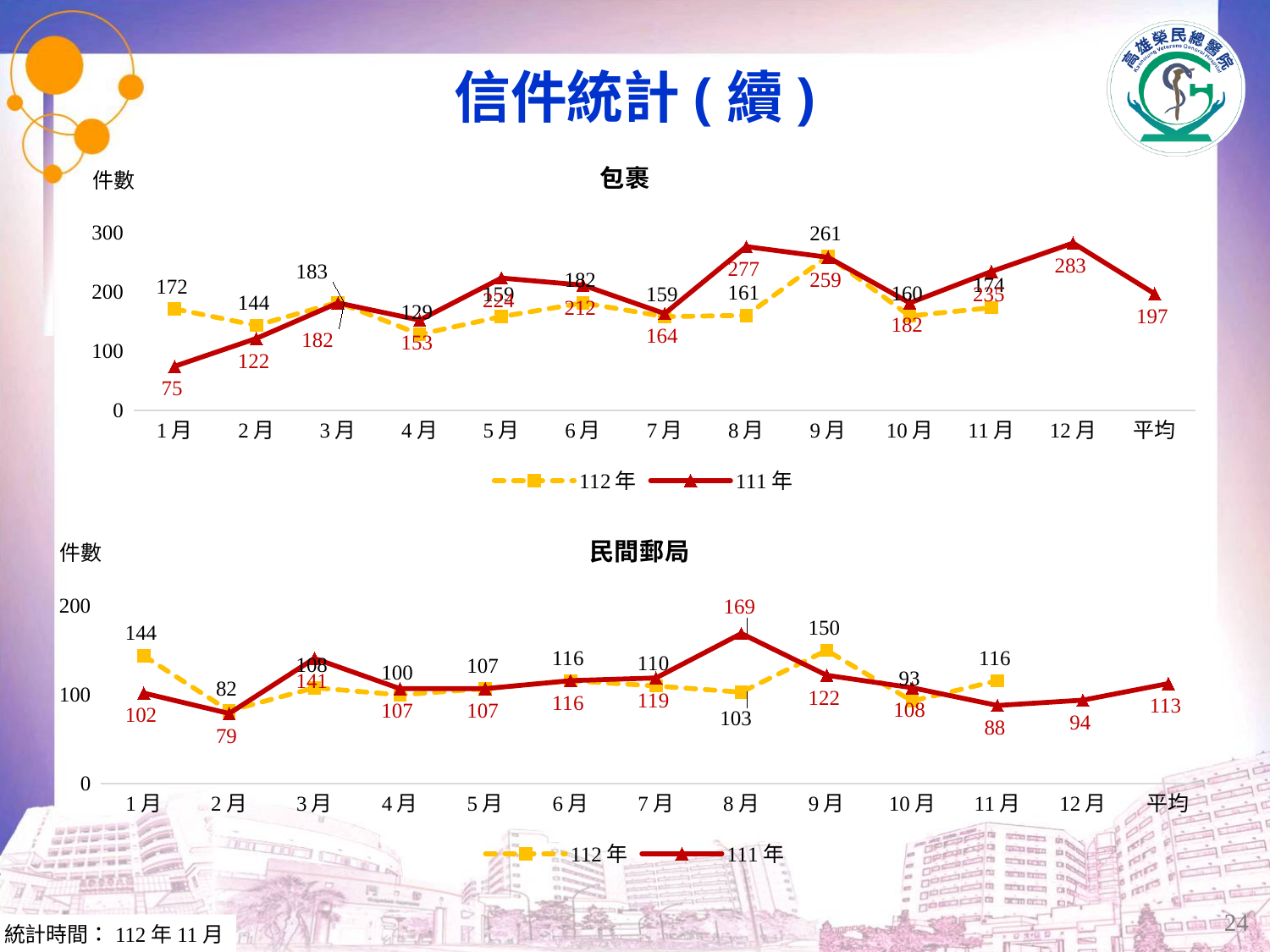
In the 民間郵局 chart, what is the 平均 value for 111年? 113 In the 包裹 chart, which month has the highest value for 111年? 12月 In the 民間郵局 chart, which month has the lowest value for 111年? 2月 In the 民間郵局 chart, which series has the larger value in 1月, 112年 or 111年? 112年 In the 民間郵局 chart, which month has the highest value for 112年? 9月 In the 包裹 chart, what is the difference between the 112年 and 111年 values in 1月? 97 In the 包裹 chart, what is the value for 111年 in 12月? 283 In the 包裹 chart, what is the value for 112年 in 9月? 261 In the 包裹 chart, which month has the lowest value for 111年? 1月 What kind of chart is the 包裹 chart at the top of the slide? line chart How many series does the legend of the 民間郵局 chart list? 2 In the 民間郵局 chart, what is the value for 111年 in 8月? 169